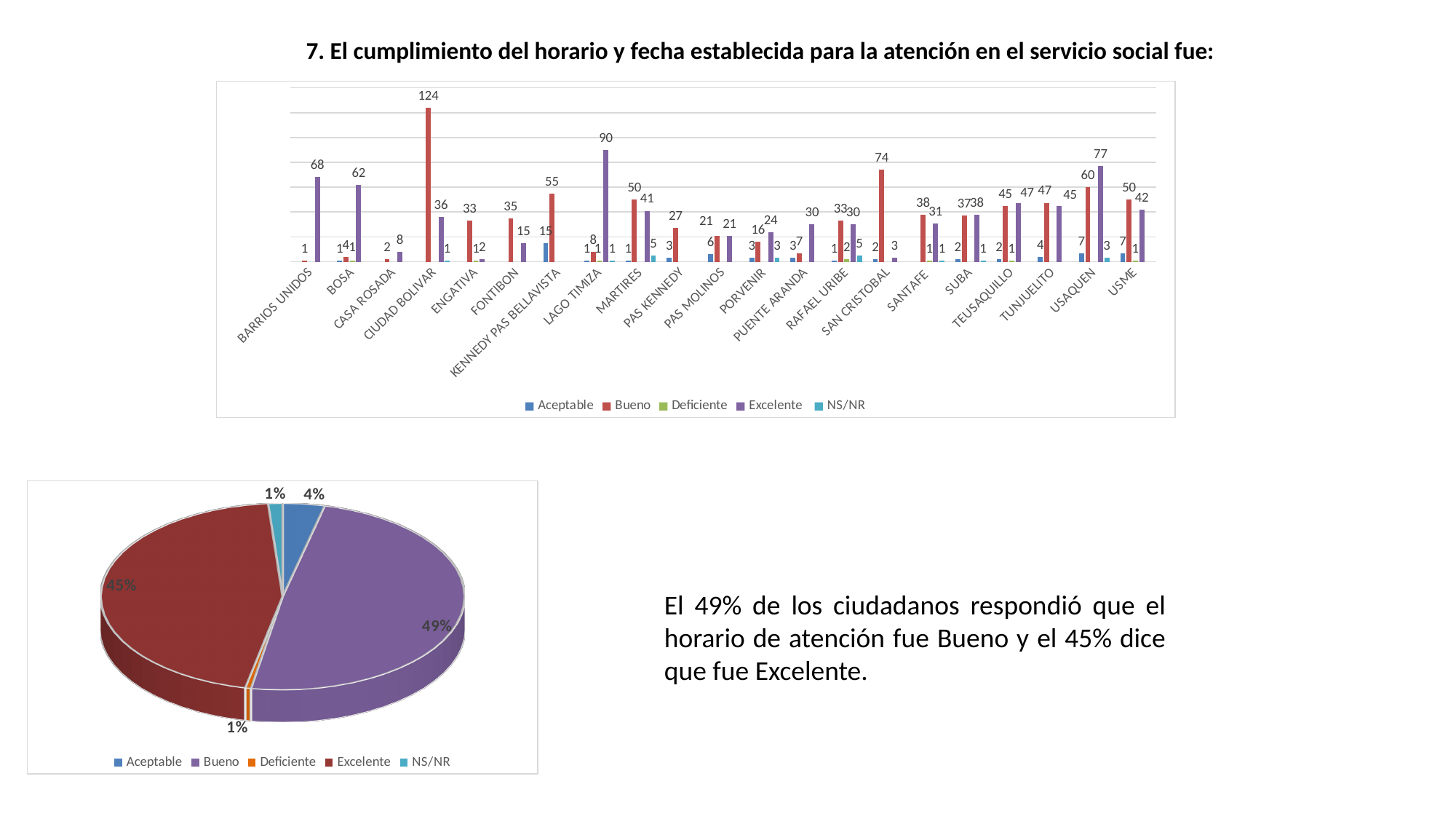
How many categories are shown on the x axis of the top bar chart? 21 How many series does the legend of the top bar chart list? 5 In the bottom-left pie chart, what share does Aceptable have? 4% In the top bar chart, what is the Bueno value for CIUDAD BOLIVAR? 124 In the top bar chart, which category has the highest Bueno value? CIUDAD BOLIVAR In the bottom-left pie chart, what share does Excelente have? 45% In the bottom-left pie chart, what share does Bueno have? 49% In the top bar chart, what is the Excelente value for LAGO TIMIZA? 90 What kind of chart is the chart at the bottom left of the slide? Pie chart In the top bar chart, what is the difference between the Bueno and Excelente values for SAN CRISTOBAL? 71 In the top bar chart, what is the Excelente value for USAQUEN? 77 In the top bar chart, which is larger for MARTIRES: the Bueno value or the Excelente value? Bueno